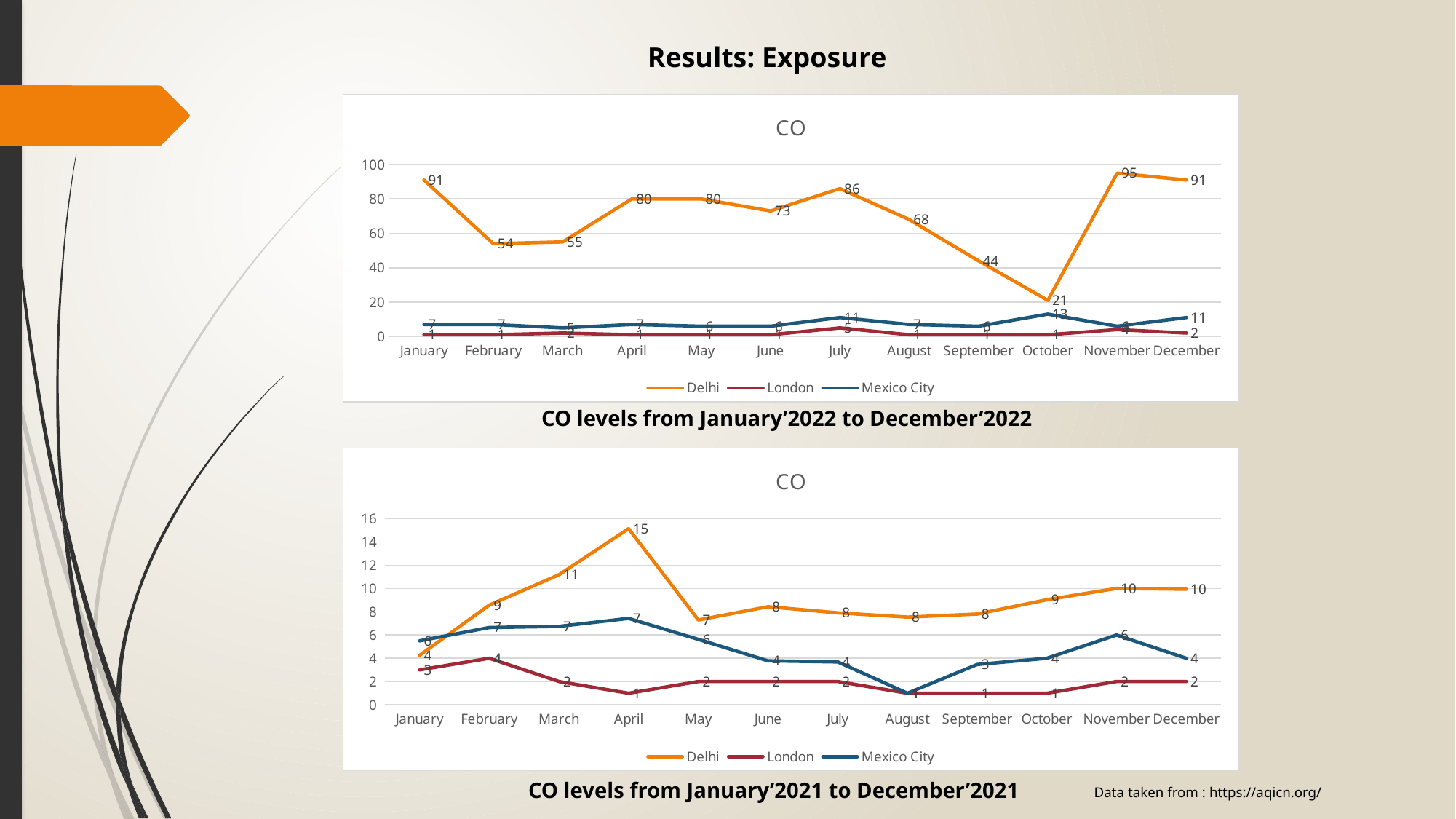
In the top chart (CO levels from January'2022 to December'2022), which month has the highest Delhi value? November In the bottom chart (CO levels from January'2021 to December'2021), what is the Delhi value for April? 15 In the top chart (CO levels from January'2022 to December'2022), is the Delhi value for September greater or less than 40? greater In the bottom chart (CO levels from January'2021 to December'2021), what is the London value for January? 3 In the bottom chart (CO levels from January'2021 to December'2021), which month has the lowest Delhi value? January In the top chart (CO levels from January'2022 to December'2022), what is the difference between the Delhi values for January and February? 37 In the top chart (CO levels from January'2022 to December'2022), what is the Delhi value for October? 21 How many months are plotted along the x axis of the bottom chart (CO levels from January'2021 to December'2021)? 12 What kind of chart is the bottom chart (CO levels from January'2021 to December'2021)? Line chart In the bottom chart (CO levels from January'2021 to December'2021), which is larger in February: the Delhi value or the Mexico City value? Delhi How many series does the legend of the top chart (CO levels from January'2022 to December'2022) list? 3 In the top chart (CO levels from January'2022 to December'2022), what is the Mexico City value for October? 13